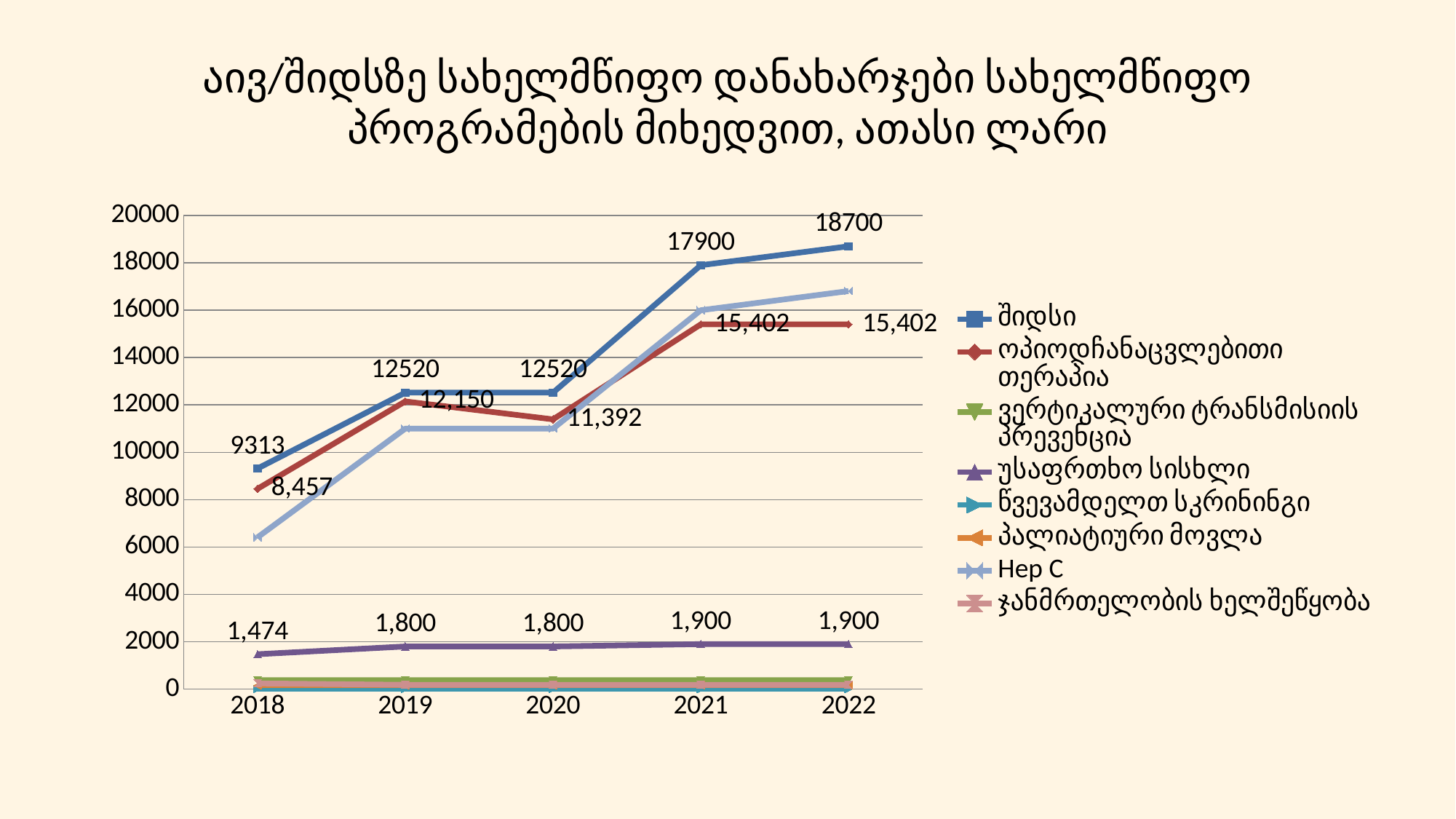
What is the difference between the შიდსი values in 2021 and 2018? 8587 How many series does the legend list? 8 How many years are shown on the x axis? 5 What is the value for შიდსი in 2022? 18700 Is the value for Hep C in 2018 greater or less than 8000? less In which year does the შიდსი series reach its highest value? 2022 Does the უსაფრთხო სისხლი series rise or fall from 2018 to 2022? rise What is the value for ოპიოდჩანაცვლებითი თერაპია in 2018? 8,457 What is the value for უსაფრთხო სისხლი in 2019? 1,800 Which series has the larger value in 2020: შიდსი or ოპიოდჩანაცვლებითი თერაპია? შიდსი What kind of chart is shown on the slide? line chart In which year is the value for ოპიოდჩანაცვლებითი თერაპია lowest? 2018